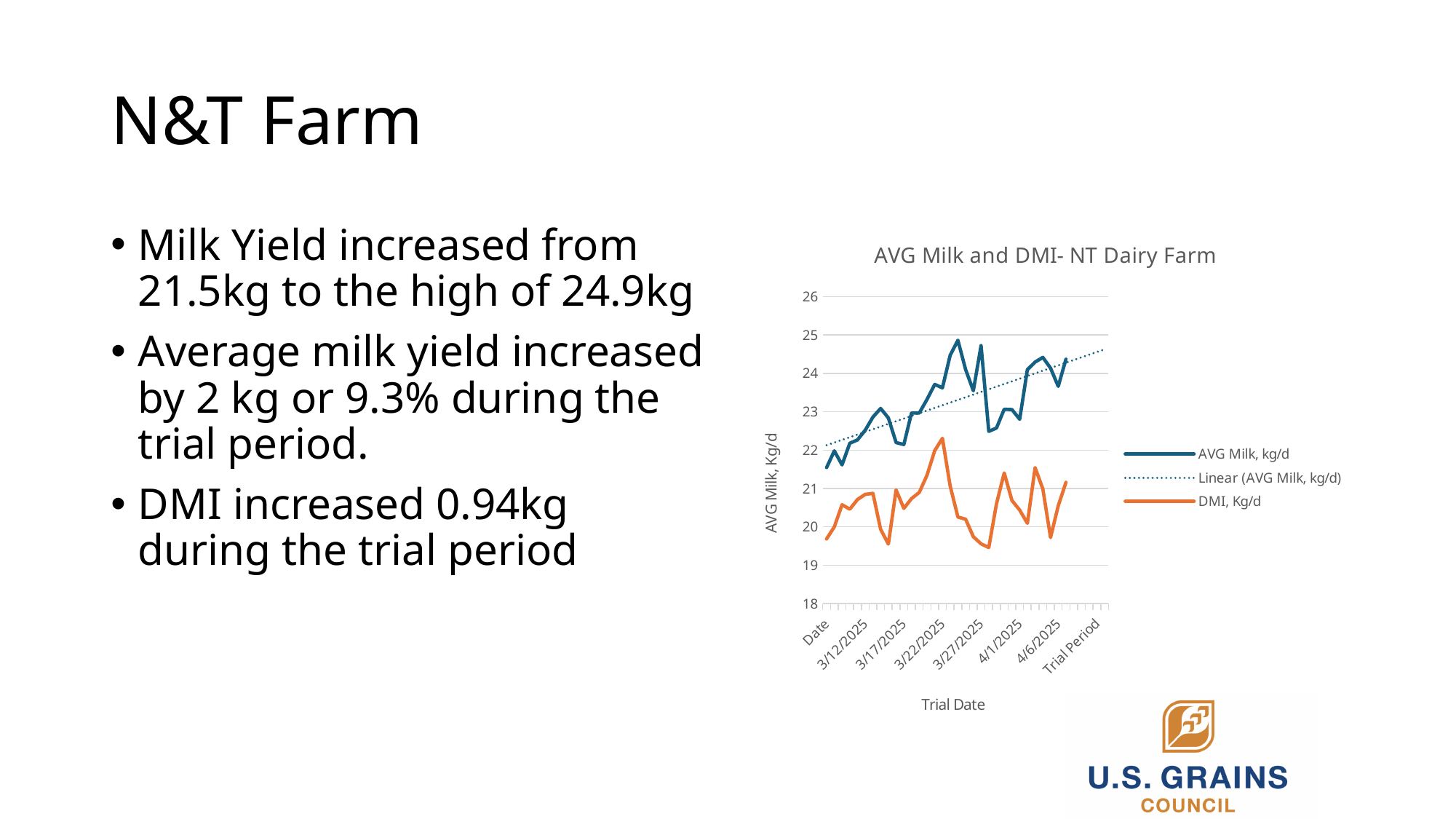
Is the highest value of the AVG Milk, kg/d series greater or less than 24? greater Is the lowest value of the DMI, Kg/d series greater or less than 20? less Is the highest value of the DMI, Kg/d series greater or less than 23? less What is the label on the horizontal axis of the chart? Trial Date Which series has higher values throughout the chart, AVG Milk, kg/d or DMI, Kg/d? AVG Milk, kg/d Does the AVG Milk, kg/d series generally rise or fall across the trial dates? Rise How many entries does the chart legend list? 3 What kind of chart is shown on the slide? Line chart Which series is drawn in orange in the chart? DMI, Kg/d What is the label on the vertical axis of the chart? AVG Milk, Kg/d